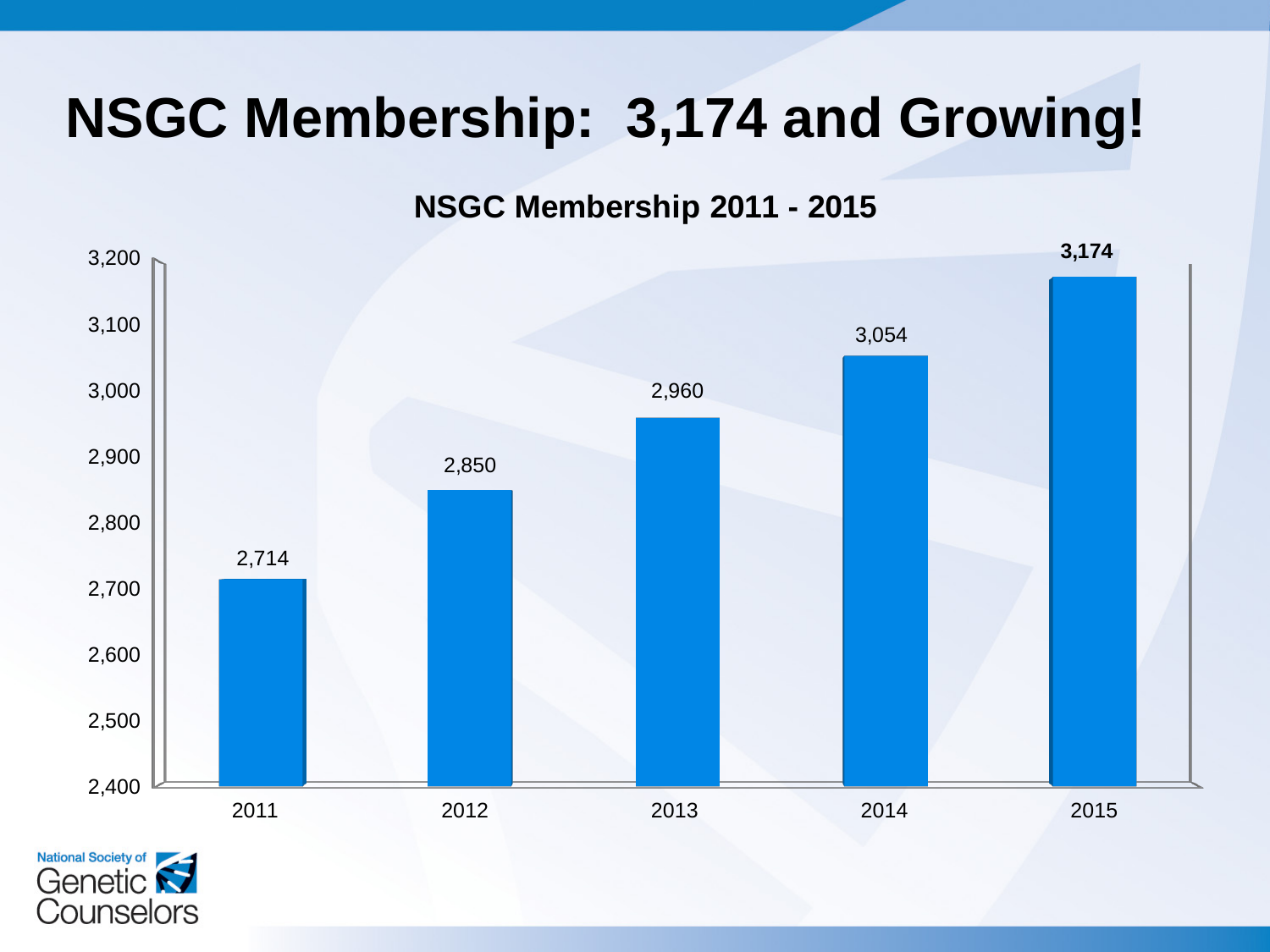
What kind of chart is shown on the slide? Bar chart Is the membership value for 2012 greater or less than 2,900? less By how much did NSGC membership increase from 2011 to 2015? 460 What was NSGC membership in 2013? 2,960 How many years are shown on the chart? 5 What is the difference in membership between 2014 and 2013? 94 Which year had the lowest NSGC membership? 2011 What was NSGC membership in 2011? 2,714 Which year had higher membership, 2012 or 2014? 2014 What was NSGC membership in 2015? 3,174 Does NSGC membership rise or fall from 2011 to 2015? Rise Which year had the highest NSGC membership? 2015